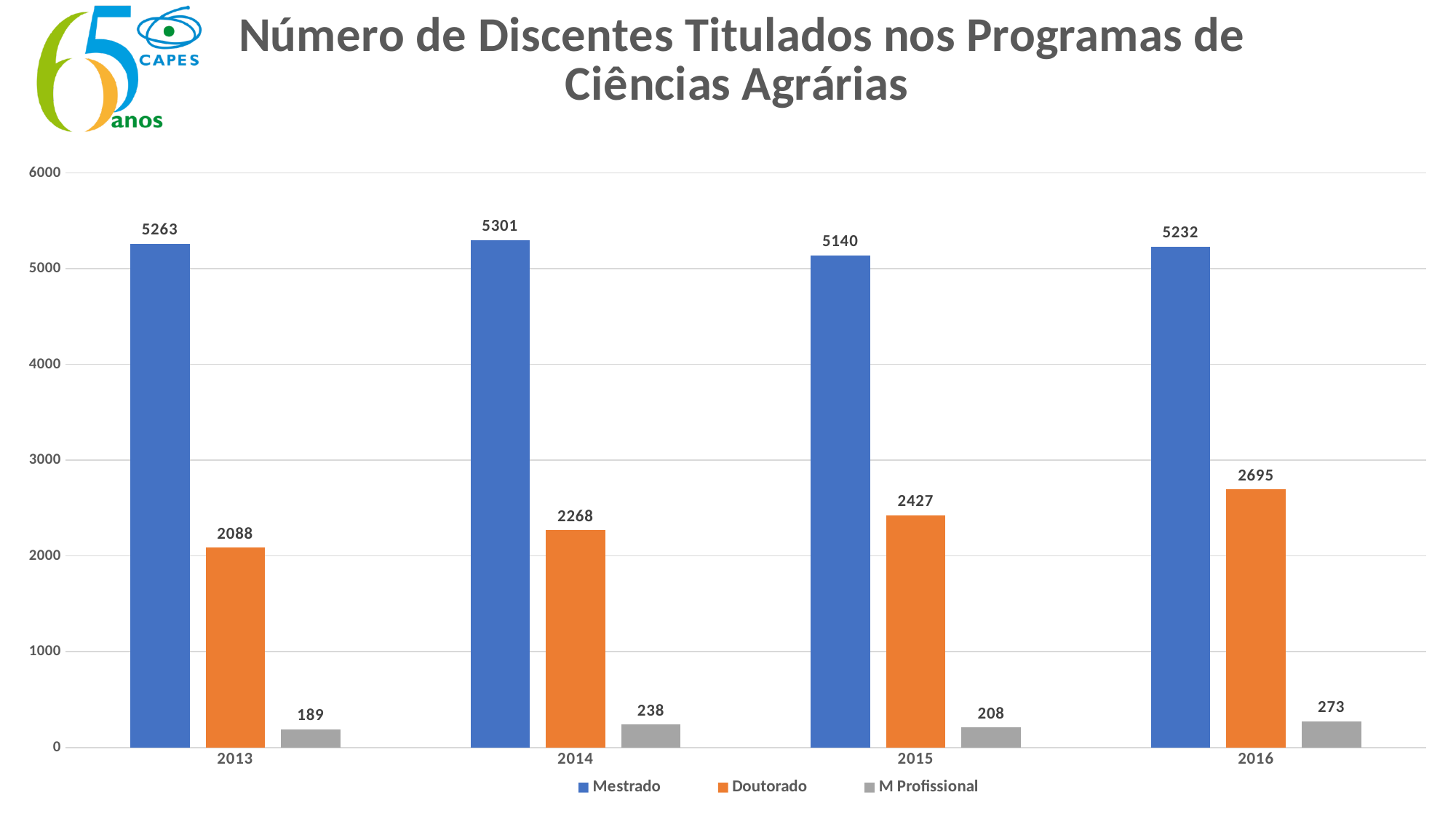
What is the value for Doutorado in 2016? 2695 What is the value for Mestrado in 2014? 5301 How many series does the legend list? 3 In which year is the Mestrado value highest? 2014 What kind of chart is shown? bar chart What is the value for M Profissional in 2013? 189 How many years are shown on the x axis? 4 Is the value for Doutorado in 2015 greater or less than 3000? less Do the Doutorado values rise or fall from 2013 to 2016? rise What is the difference between the Mestrado values for 2014 and 2015? 161 Which is larger, the M Profissional value for 2014 or for 2015? 2014 In which year is the Doutorado value lowest? 2013